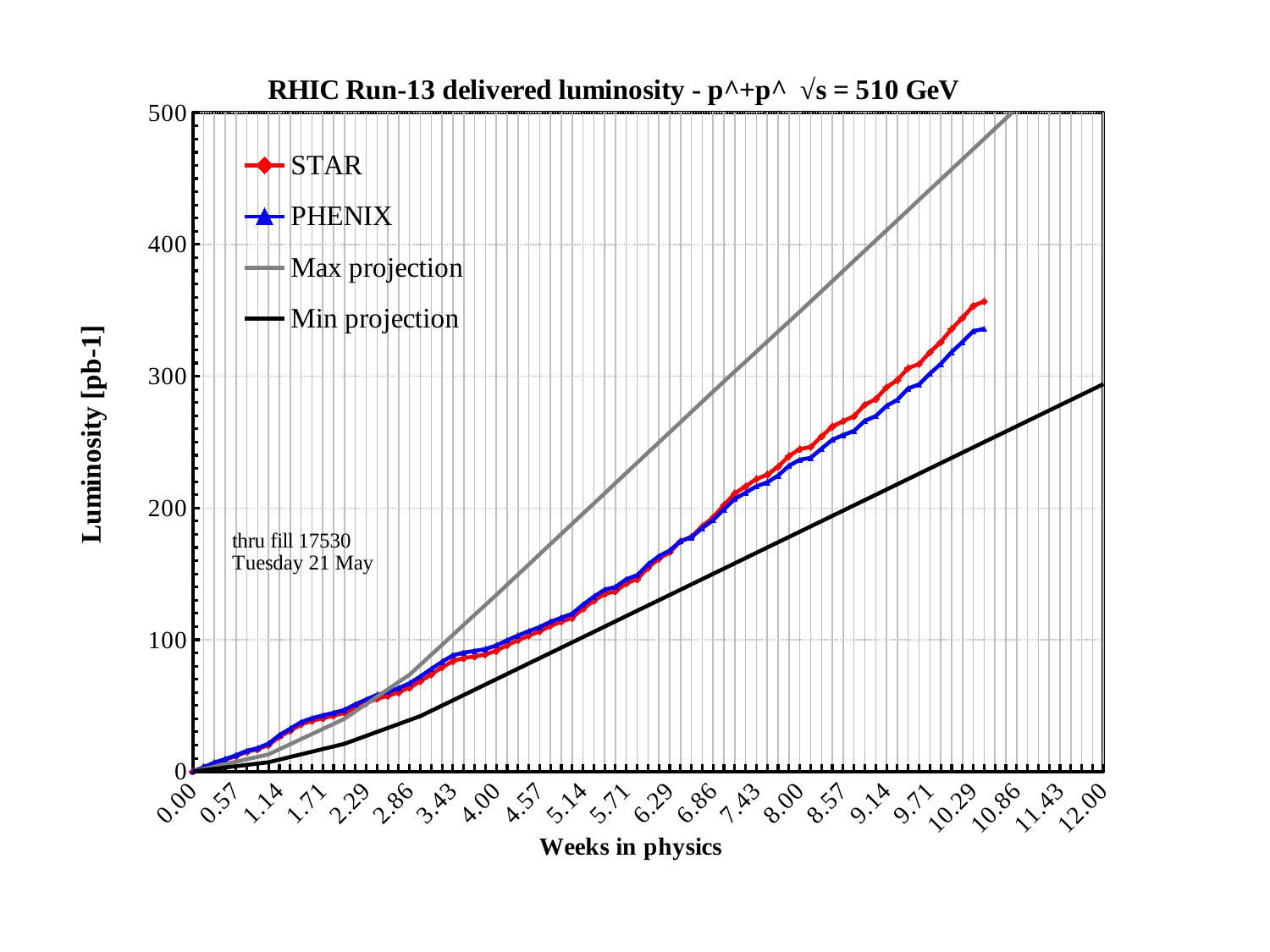
At the end of the STAR data (around week 10.29), is the STAR value greater or less than 300? greater What kind of chart is shown on the slide? Line chart What is the label of the y axis? Luminosity [pb-1] At week 8.00, is the STAR value greater or less than 200? greater Which series has the lowest value at week 10.29? Min projection What is the title of the chart? RHIC Run-13 delivered luminosity - p^+p^ √s = 510 GeV How many series does the legend list? 4 At the end of the measured data (around week 10.29), which is larger, the STAR value or the PHENIX value? STAR Do the STAR and PHENIX luminosity values rise or fall as weeks in physics increase? Rise At week 12.00, is the Min projection value greater or less than 400? less